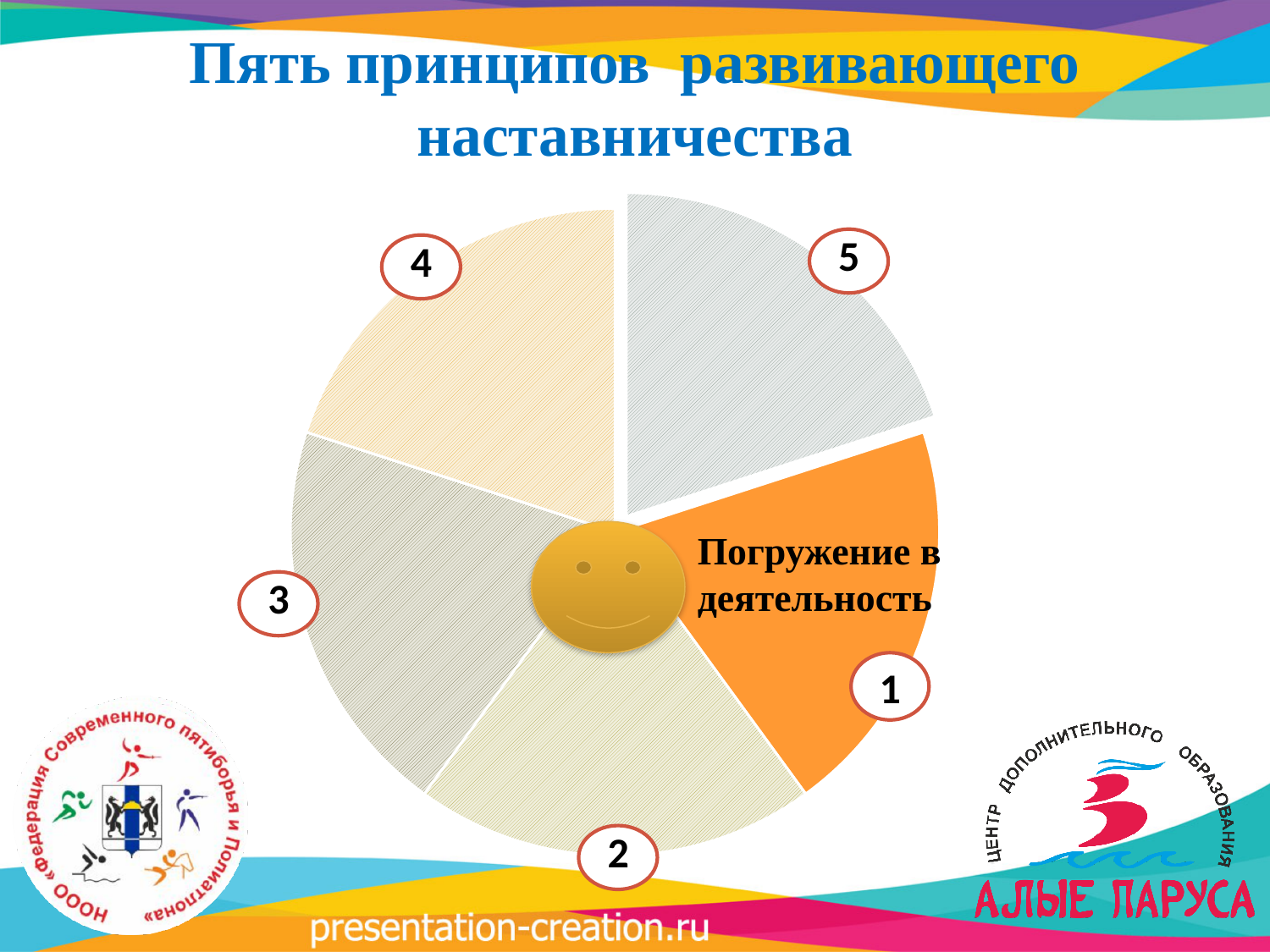
What text label is shown on segment 1 of the pie chart? Погружение в деятельность What is the title of the slide above the pie chart? Пять принципов развивающего наставничества How many segments does the pie chart have? 5 What kind of chart is shown on the slide? pie chart What is the highest segment number shown on the pie chart? 5 Which segment of the pie chart is labelled with text? 1 Which numbered segment of the pie chart is coloured orange? 1